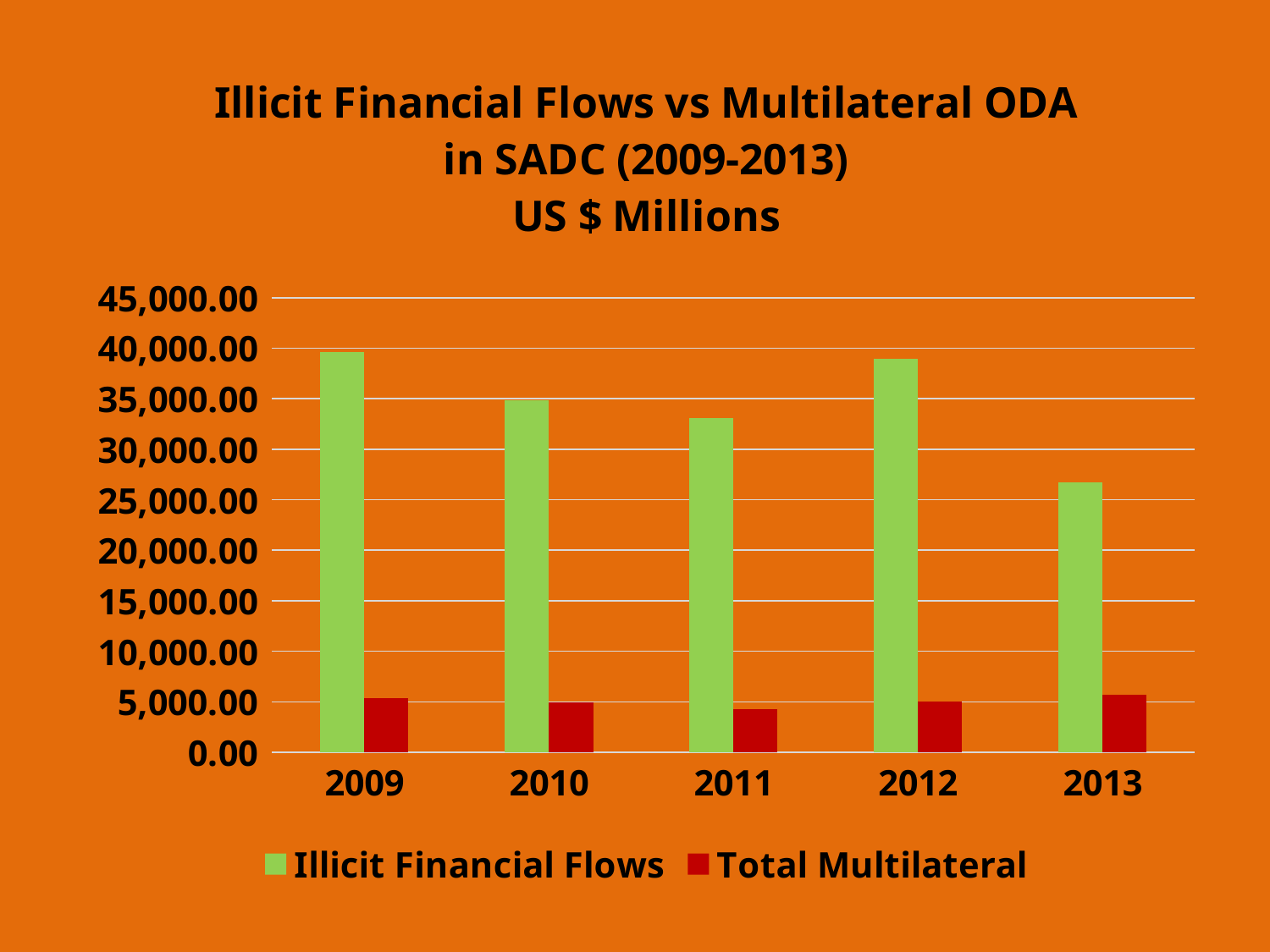
How many series does the legend list? 2 Which is larger, Total Multilateral in 2009 or in 2011? 2009 What unit is stated in the chart title? US $ Millions In which year is the Illicit Financial Flows value lowest? 2013 Is the Illicit Financial Flows value for 2009 greater or less than 35,000.00? greater Is the Total Multilateral value for 2011 greater or less than 5,000.00? less Which is larger, Illicit Financial Flows in 2009 or in 2013? 2009 Is the Illicit Financial Flows value for 2011 greater or less than 35,000.00? less In which year is the Total Multilateral value lowest? 2011 What kind of chart is shown on the slide? bar chart How many years are shown on the x axis? 5